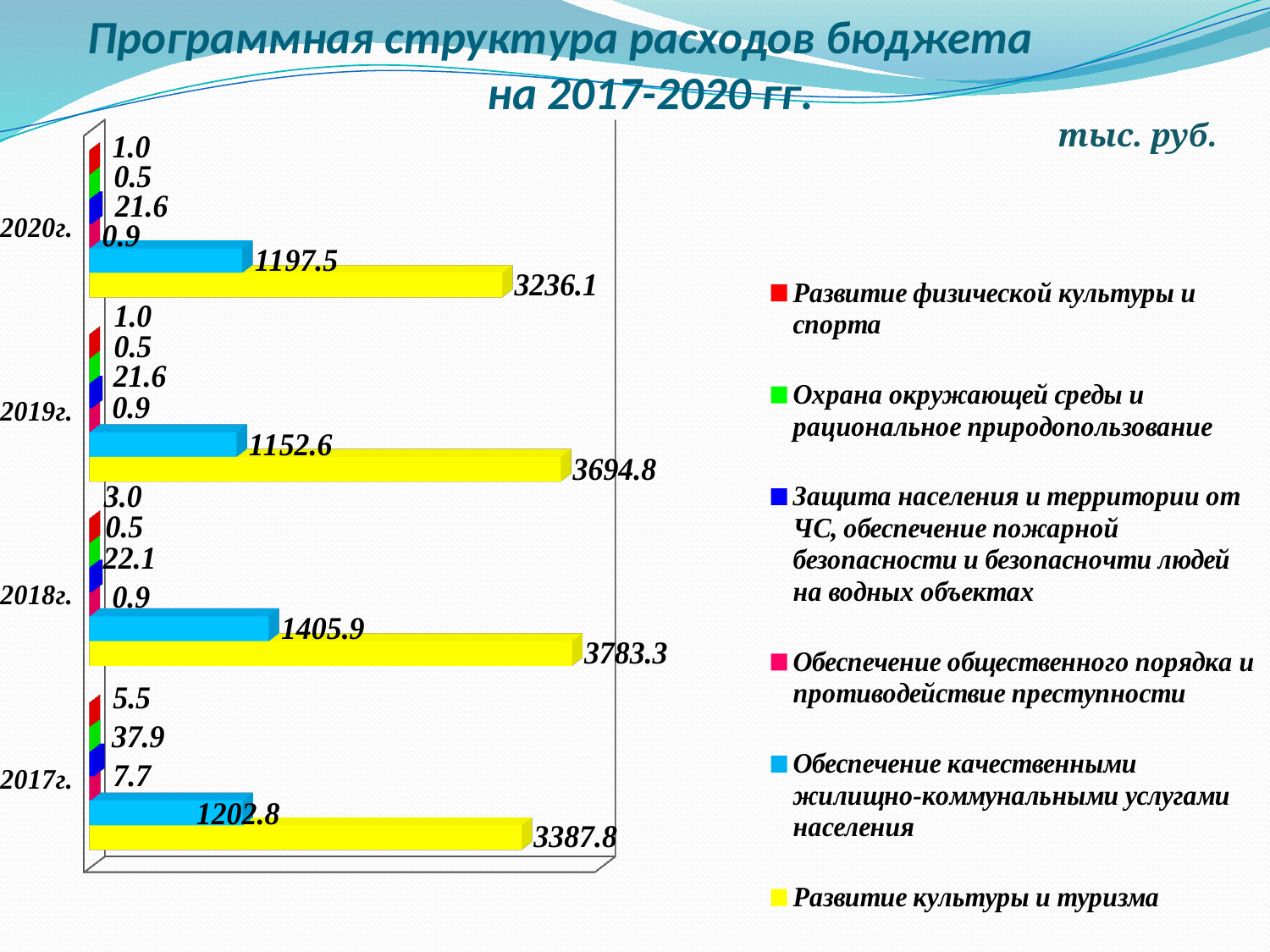
What is the value for Обеспечение качественными жилищно-коммунальными услугами населения in 2020г.? 1197.5 What is the value for Защита населения и территории от ЧС in 2018г.? 22.1 How many series does the legend list? 6 How many years (categories) are shown on the chart? 4 What is the difference between the Развитие культуры и туризма values for 2019г. and 2020г.? 458.7 What is the value for Развитие культуры и туризма in 2018г.? 3783.3 Which is larger: the Обеспечение качественными жилищно-коммунальными услугами населения value for 2017г. or for 2019г.? 2017г. In which year is the value for Развитие культуры и туризма the highest? 2018г. What unit is indicated for the chart values? тыс. руб. What kind of chart is shown on the slide? Bar chart In which year is the value for Развитие культуры и туризма the lowest? 2020г. What is the value for Развитие культуры и туризма in 2017г.? 3387.8